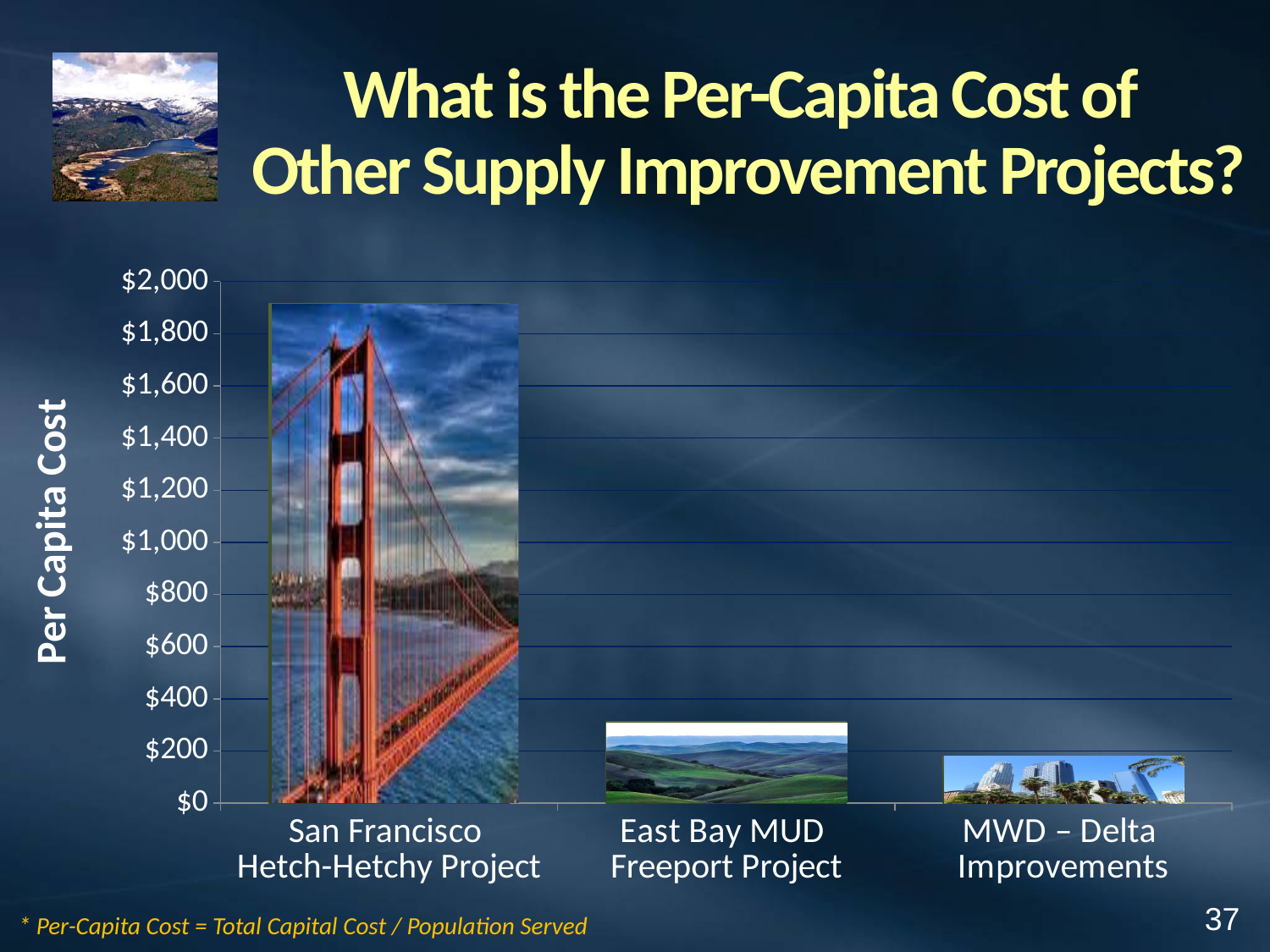
How many projects are compared in the chart? 3 Which project has the highest per capita cost? San Francisco Hetch-Hetchy Project Do the per capita costs rise or fall moving from left to right across the chart? fall Which project has the lowest per capita cost? MWD – Delta Improvements What is the label on the vertical axis of the chart? Per Capita Cost Is the per capita cost for the San Francisco Hetch-Hetchy Project greater or less than $2,000? less Which has a larger per capita cost, the East Bay MUD Freeport Project or the MWD – Delta Improvements? East Bay MUD Freeport Project Is the per capita cost for the East Bay MUD Freeport Project greater or less than $400? less Is the per capita cost for the MWD – Delta Improvements greater or less than $400? less What kind of chart is shown on the slide? bar chart Which has a larger per capita cost, the San Francisco Hetch-Hetchy Project or the East Bay MUD Freeport Project? San Francisco Hetch-Hetchy Project